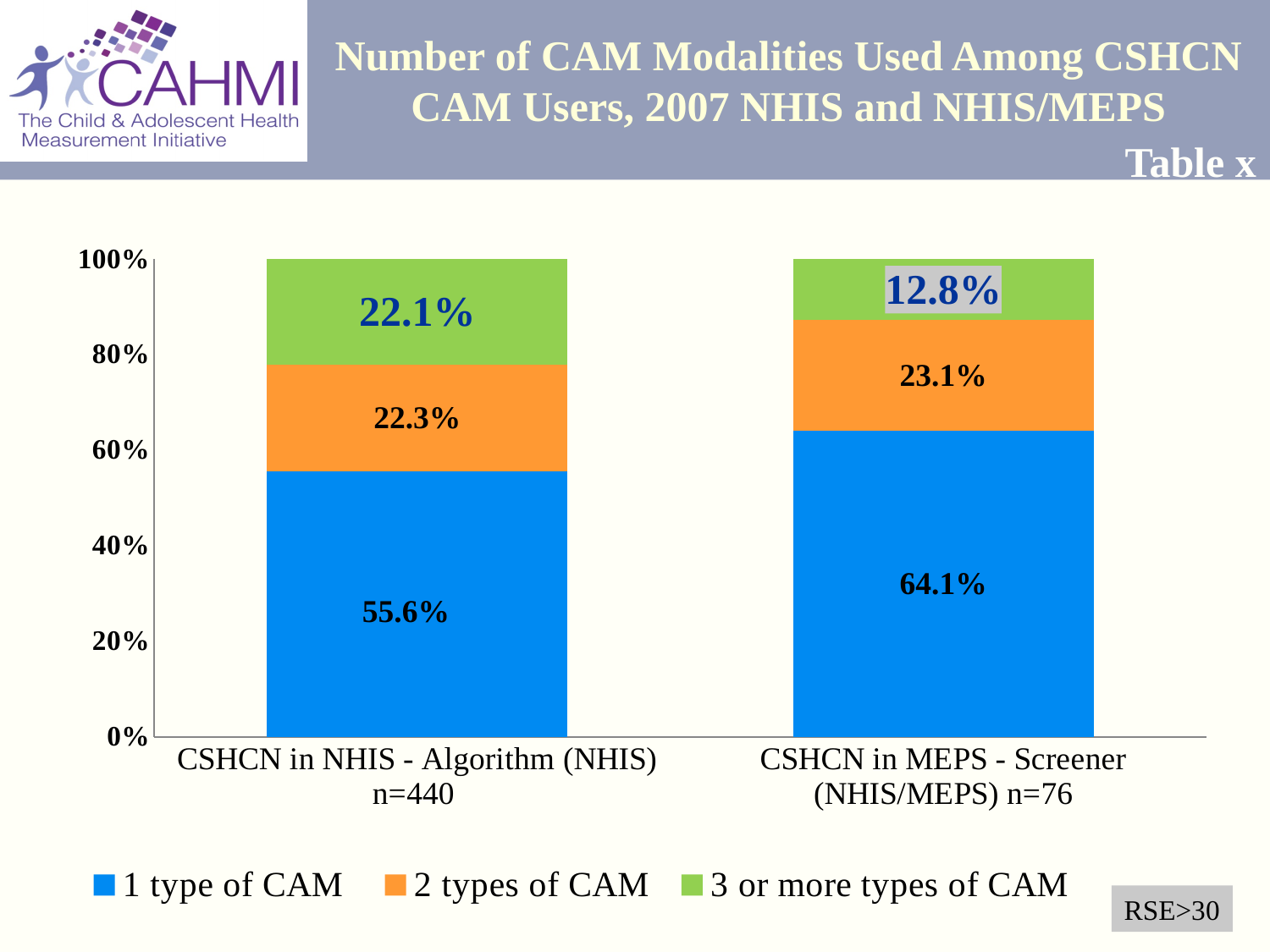
What is the difference between the 3 or more types of CAM shares for the NHIS Algorithm group and the MEPS Screener group? 9.3% What is the sample size (n) for the CSHCN in MEPS - Screener (NHIS/MEPS) group? n=76 What percentage of CSHCN in NHIS - Algorithm (NHIS) CAM users used 1 type of CAM? 55.6% What percentage of CSHCN in MEPS - Screener (NHIS/MEPS) CAM users used 3 or more types of CAM? 12.8% What kind of chart is shown on the slide? Stacked bar chart Which group has the larger share of CAM users using 1 type of CAM? CSHCN in MEPS - Screener (NHIS/MEPS) What is the difference between the 1 type of CAM shares for the MEPS Screener group and the NHIS Algorithm group? 8.5% Which segment is the smallest in the CSHCN in MEPS - Screener (NHIS/MEPS) bar? 3 or more types of CAM What is the value for 3 or more types of CAM in the CSHCN in NHIS - Algorithm (NHIS) bar? 22.1% How many groups (bars) are shown on the x axis? 2 How many series does the legend list? 3 What is the value for 2 types of CAM in the CSHCN in MEPS - Screener (NHIS/MEPS) bar? 23.1%